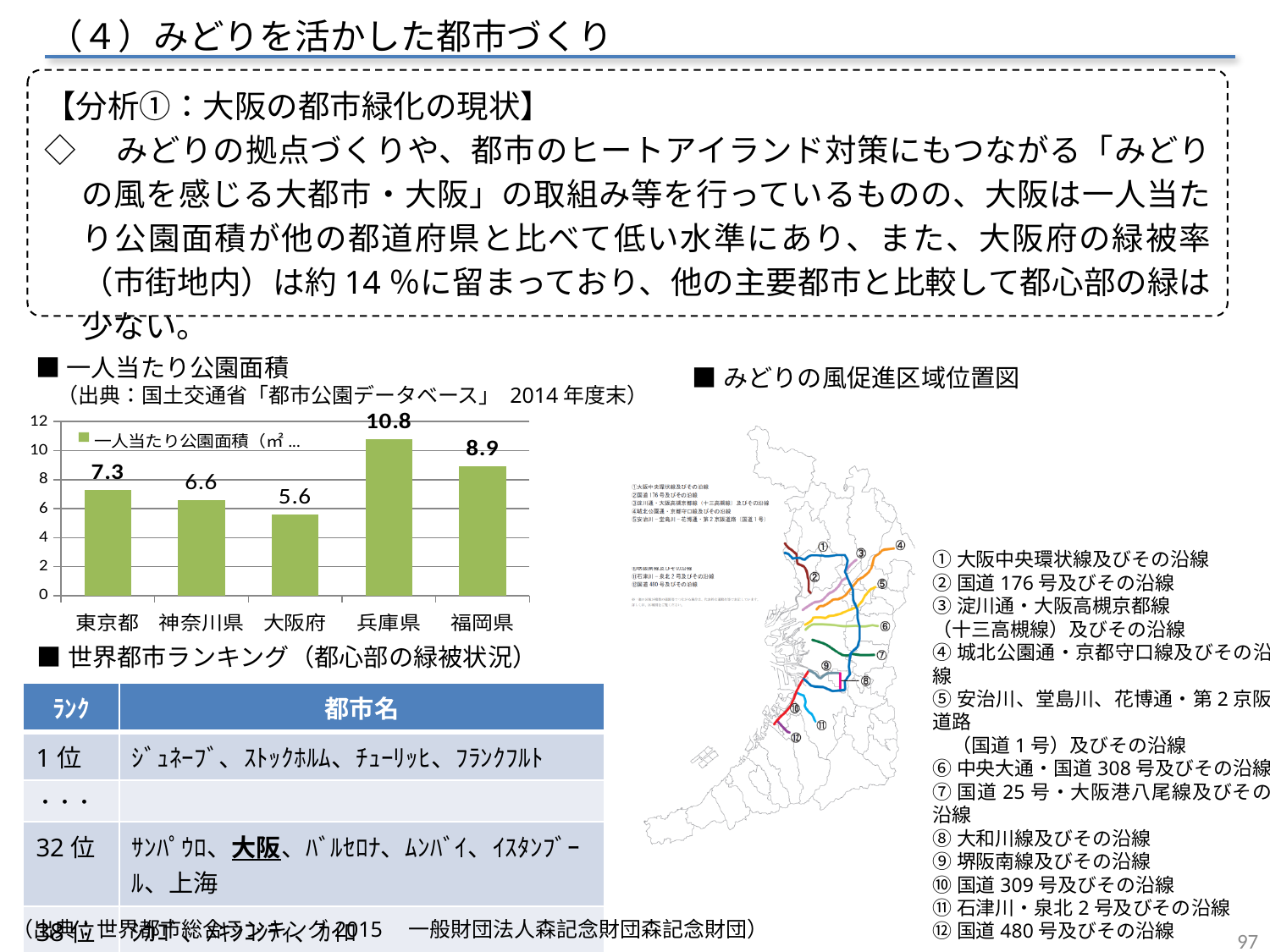
What is the value for 福岡県 in the 一人当たり公園面積 chart? 8.9 In the 一人当たり公園面積 chart, which is larger, the value for 東京都 or 神奈川県? 東京都 What is the difference between the values for 兵庫県 and 大阪府 in the 一人当たり公園面積 chart? 5.2 What is the difference between the values for 東京都 and 神奈川県 in the 一人当たり公園面積 chart? 0.7 What is the value for 東京都 in the 一人当たり公園面積 chart? 7.3 Is the value for 福岡県 in the 一人当たり公園面積 chart greater or less than 8? greater Which category has the highest value in the 一人当たり公園面積 chart? 兵庫県 What kind of chart is the 一人当たり公園面積 chart? bar chart How many categories are shown in the 一人当たり公園面積 chart? 5 What is the value for 兵庫県 in the 一人当たり公園面積 chart? 10.8 Which category has the lowest value in the 一人当たり公園面積 chart? 大阪府 What is the value for 大阪府 in the 一人当たり公園面積 chart? 5.6